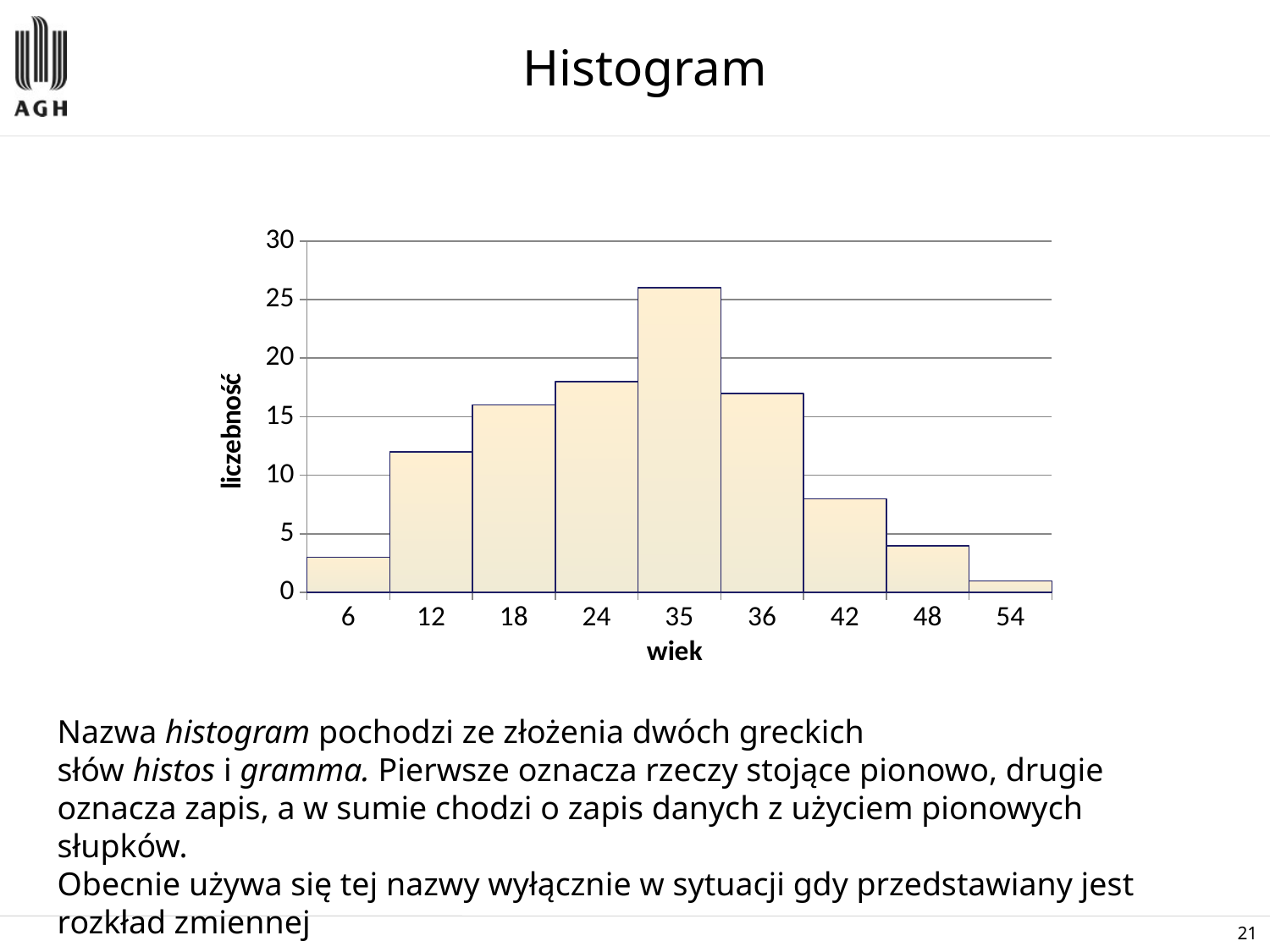
Is the value for age 24 greater or less than 20? less Do the values rise or fall from age 35 to age 54 along the x axis? fall Is the value for age 35 greater or less than 25? greater Which age category has the lowest liczebność? 54 Is the value for age 12 greater or less than 10? greater What kind of chart is shown on the slide? bar chart (histogram) Which age category has the highest liczebność? 35 How many age categories (bars) are shown on the x axis? 9 Which has the larger value, age 12 or age 42? 12 What is the label of the vertical axis? liczebność